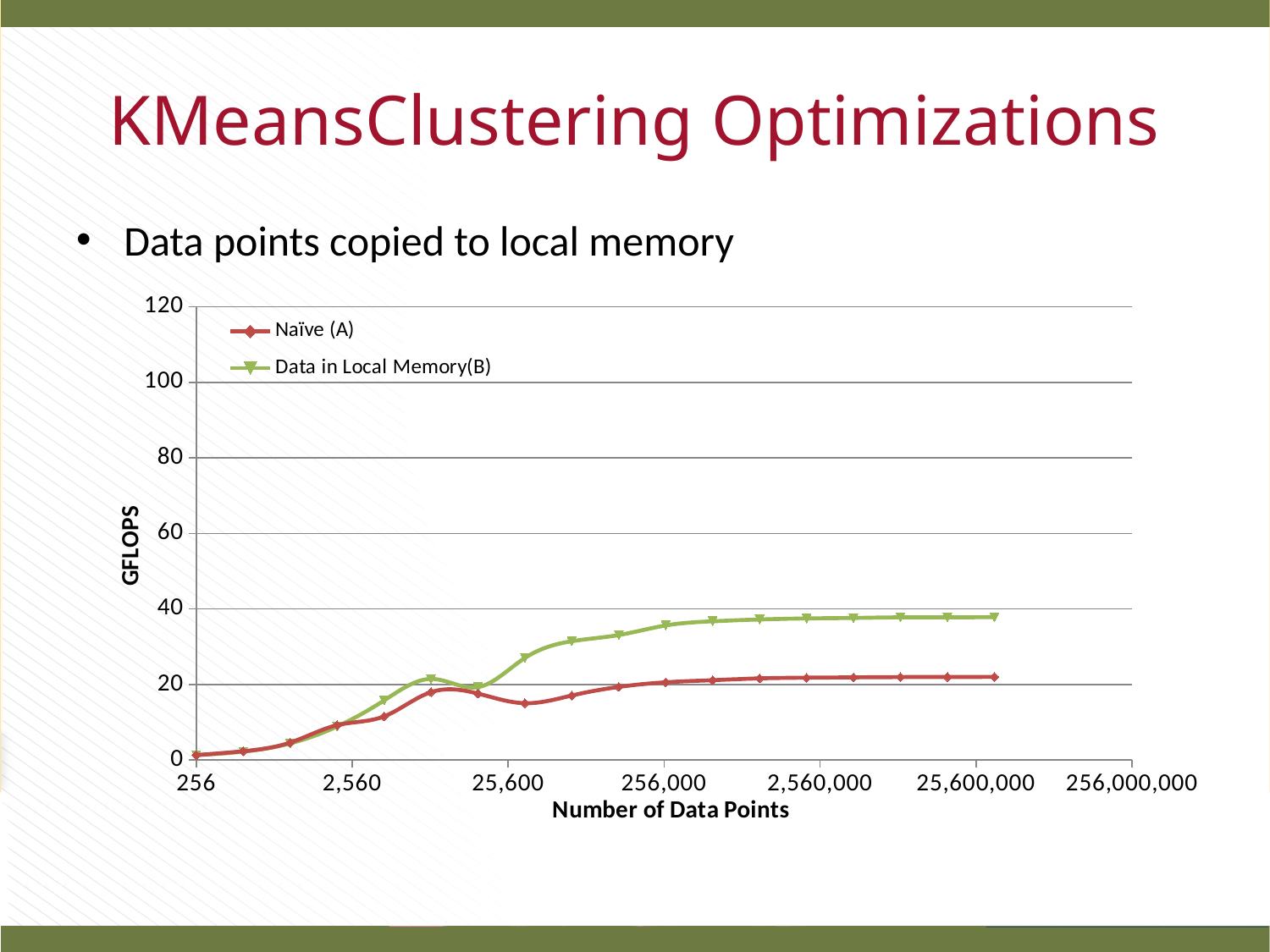
At 25,600,000 data points, which series has the higher GFLOPS value? Data in Local Memory(B) Is the value for Data in Local Memory(B) at 25,600,000 data points greater or less than 20? greater Does the Naïve (A) series generally rise or fall from 256 to 25,600,000 data points? rise At 256,000 data points, which series has the higher GFLOPS value? Data in Local Memory(B) Is the value for Naïve (A) at 256 data points greater or less than 20? less Is the value for Naïve (A) at 25,600,000 data points greater or less than 40? less Does the Data in Local Memory(B) series generally rise or fall as the number of data points increases? rise How many series does the chart's legend list? 2 What kind of chart is shown on the slide? line chart What are the two series named in the chart's legend? Naïve (A) and Data in Local Memory(B) What is the title of the chart's vertical axis? GFLOPS